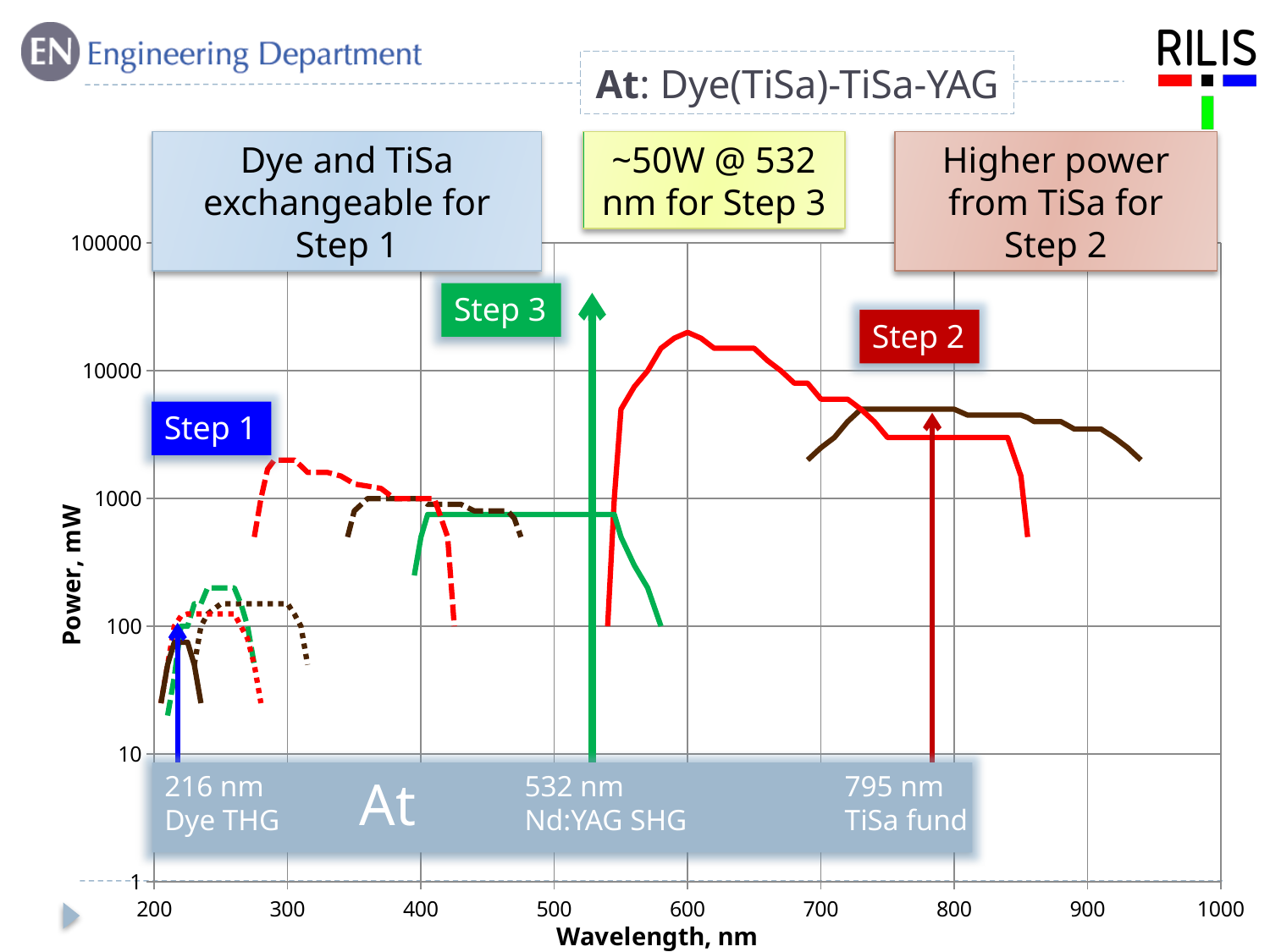
Is the power of the solid red curve at 600 nm greater or less than 10000 mW? greater At what wavelength is the Step 3 arrow placed? 532 nm Is the power of the solid green line at 500 nm greater or less than 1000 mW? less How many excitation steps are marked with arrows on the chart? 3 Is the power of the solid brown curve at 800 nm greater or less than 1000 mW? greater At what wavelength is the Step 1 arrow placed? 216 nm What is the label of the y-axis? Power, mW Does the solid red curve rise or fall between 600 nm and 850 nm? fall What is the label of the x-axis? Wavelength, nm What kind of chart is shown on the slide? line chart Which is higher: the solid red curve at 600 nm or the solid brown curve at 800 nm? the solid red curve at 600 nm At what wavelength is the Step 2 arrow placed? 795 nm